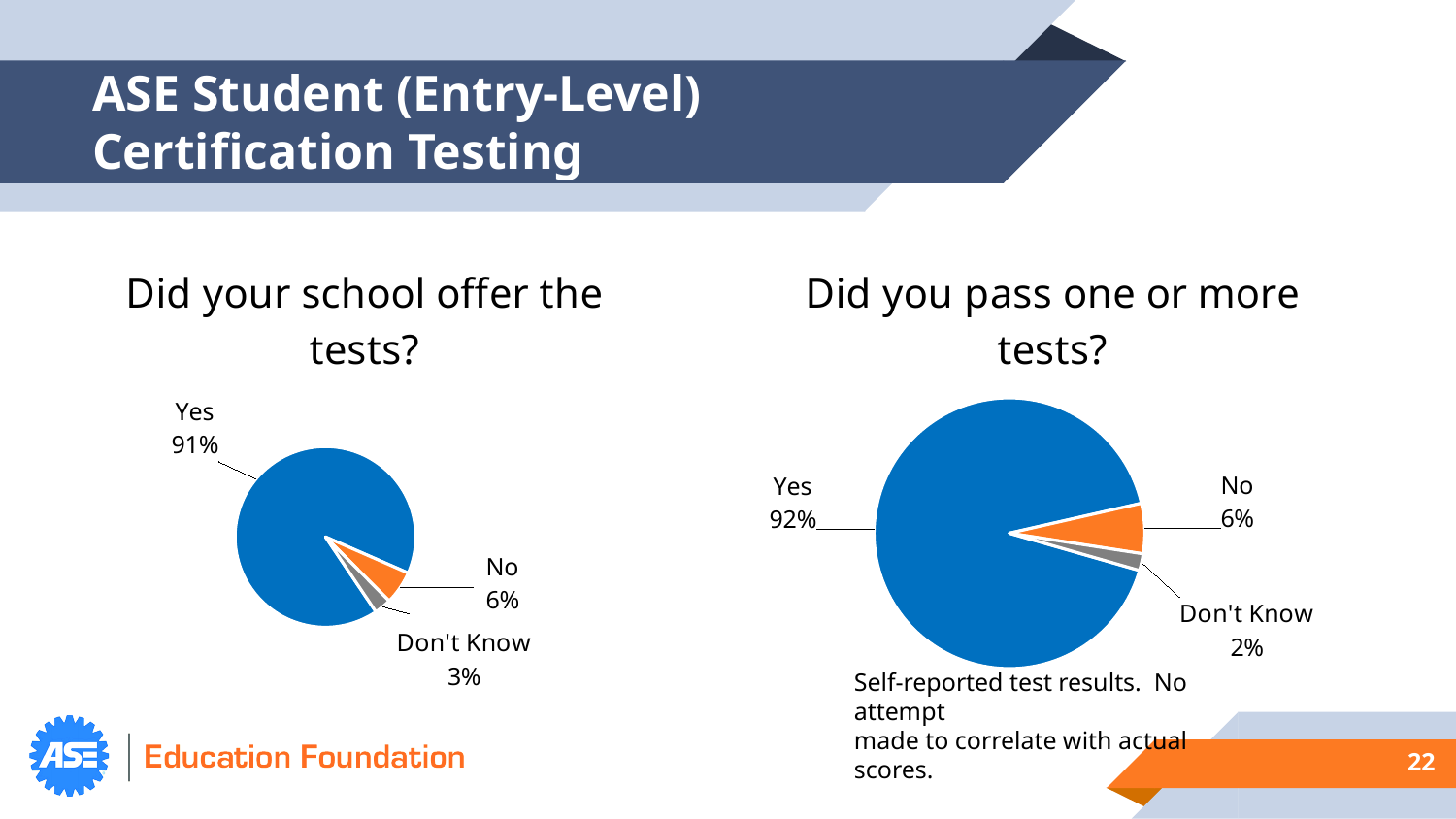
In the 'Did your school offer the tests?' chart, which response has the smallest share? Don't Know In the 'Did your school offer the tests?' chart, what percentage answered No? 6% In the 'Did your school offer the tests?' chart, what is the difference between the Yes and No percentages? 85% In the 'Did you pass one or more tests?' chart, what percentage answered Don't Know? 2% In the 'Did your school offer the tests?' chart, what percentage answered Don't Know? 3% What kind of chart is the 'Did your school offer the tests?' chart? Pie chart How many categories does the 'Did you pass one or more tests?' chart show? 3 In the 'Did you pass one or more tests?' chart, which is larger, No or Don't Know? No In the 'Did you pass one or more tests?' chart, which response has the largest share? Yes In the 'Did your school offer the tests?' chart, what percentage answered Yes? 91% In the 'Did you pass one or more tests?' chart, what colour is the Yes slice? Blue In the 'Did you pass one or more tests?' chart, what percentage answered Yes? 92%